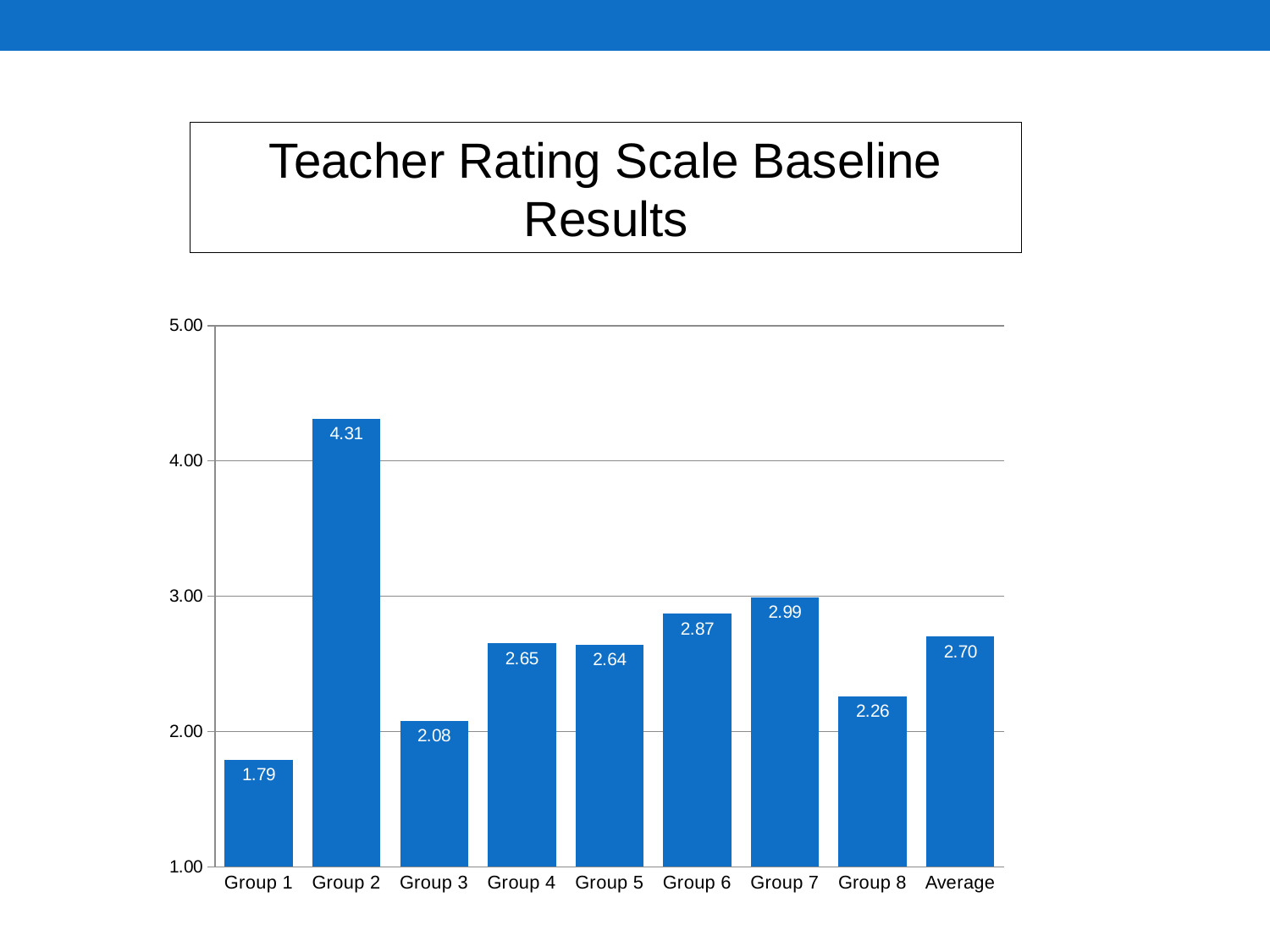
Which category has the lowest value? Group 1 Is the value for Group 7 greater or less than 4.00? less What is the value for Group 8? 2.26 What is the value shown for Average? 2.70 What is the difference between the values for Group 7 and Group 8? 0.73 Which category has the highest value? Group 2 What is the value for Group 2? 4.31 What is the title of the slide? Teacher Rating Scale Baseline Results What kind of chart is shown on the slide? bar chart What is the difference between the values for Group 2 and Group 1? 2.52 How many categories are shown on the x axis? 9 Which is larger, the value for Group 6 or the value for Group 3? Group 6